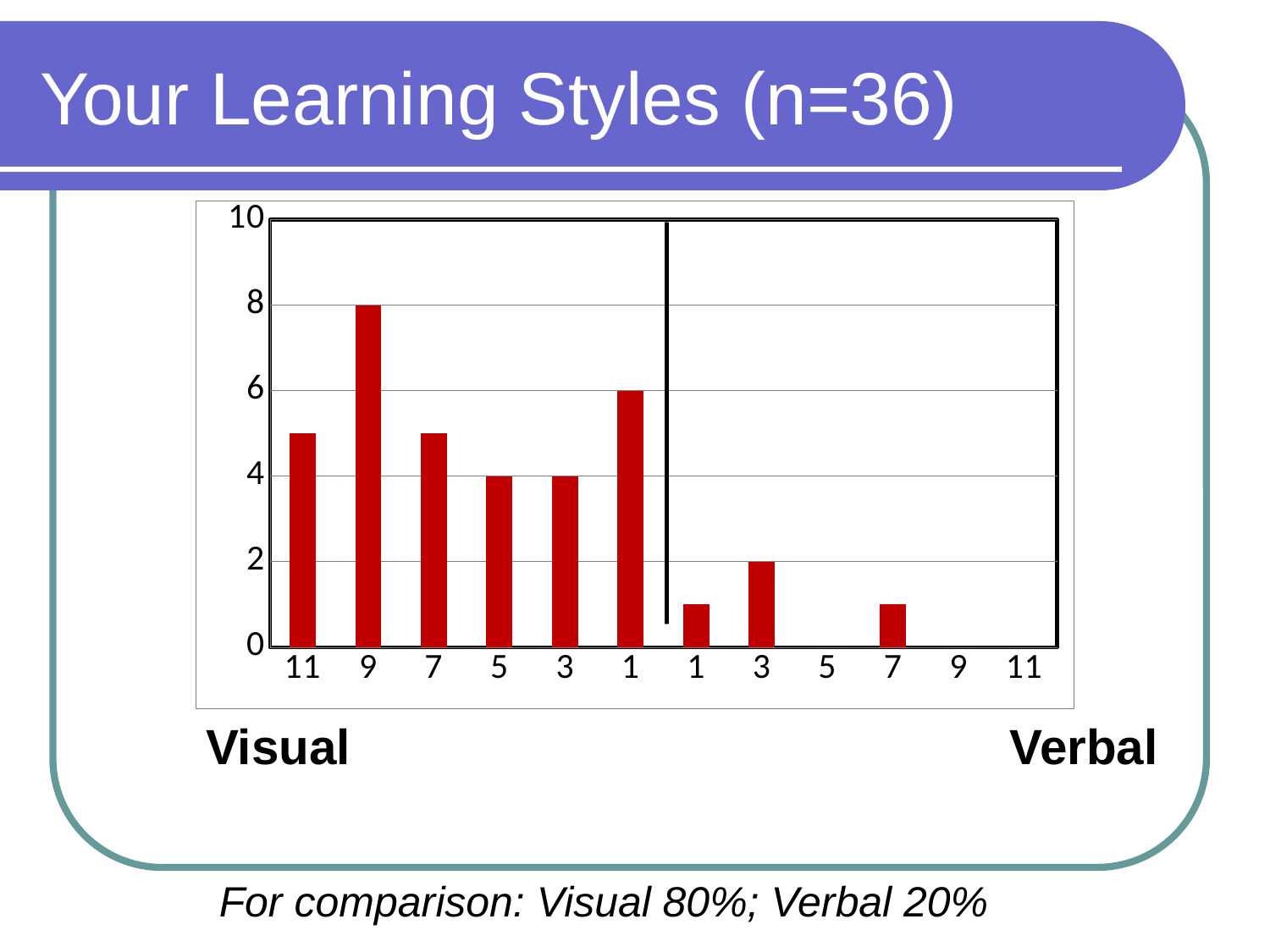
Which x-axis category has the tallest bar? 9 on the Visual side What is the title of the chart on the slide? Your Learning Styles (n=36) What is the value of the bar at 1 on the Visual side of the chart? 6 Is the value for 1 on the Verbal side greater or less than 2? less What is the value of the bar at 9 on the Visual side of the chart? 8 What kind of chart is shown on the slide? bar chart What is the value of the bar at 3 on the Verbal side of the chart? 2 How many categories are labelled along the x axis of the chart? 12 Is the value for 11 on the Visual side greater or less than 4? greater What is the difference between the bar at 9 on the Visual side and the bar at 1 on the Visual side? 2 What is the value of the bar at 5 on the Visual side of the chart? 4 Which is larger: the bar at 1 on the Visual side or the bar at 3 on the Visual side? 1 on the Visual side